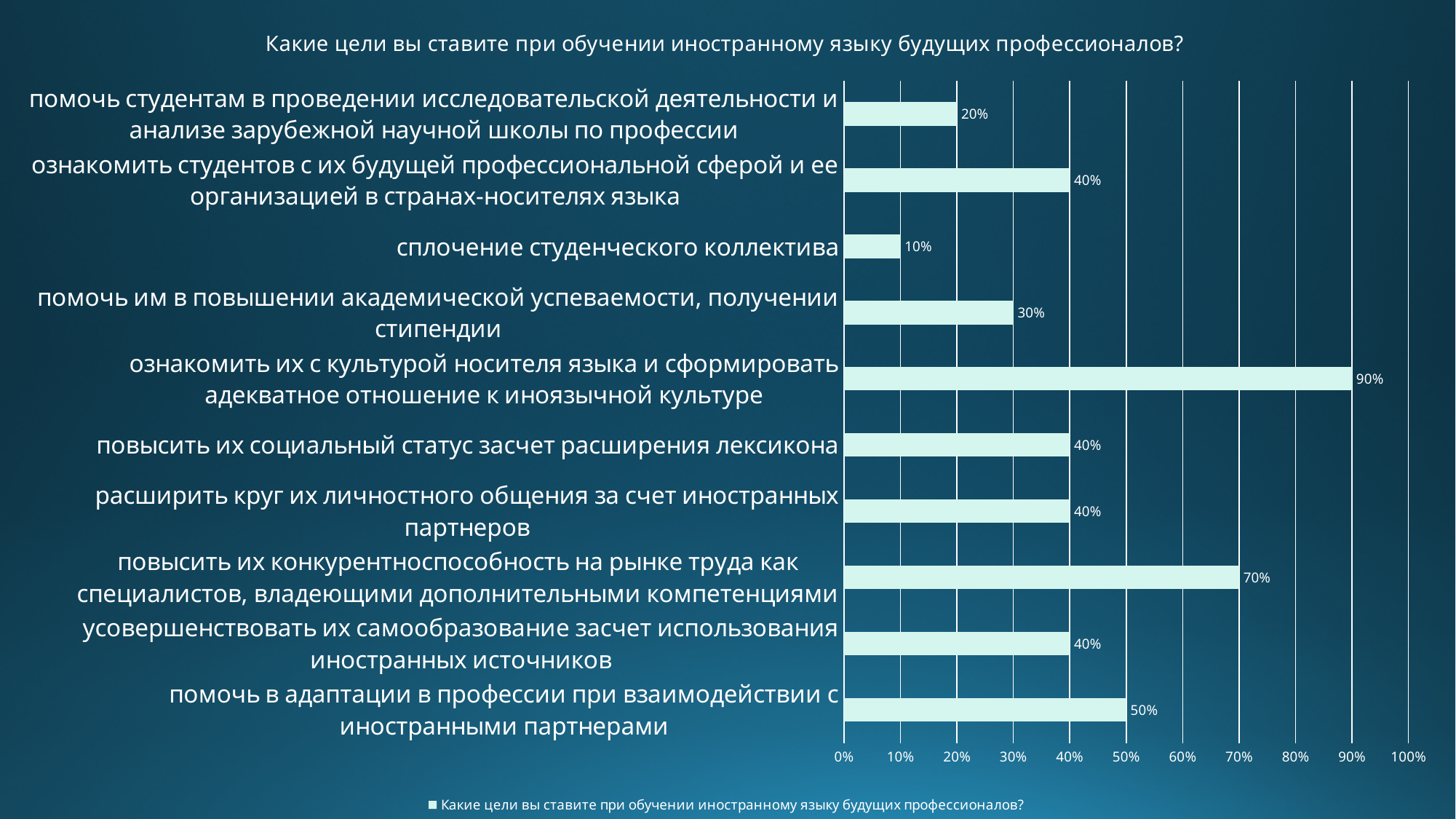
What is the difference between the value for "ознакомить их с культурой носителя языка и сформировать адекватное отношение к иноязычной культуре" and the value for "помочь в адаптации в профессии при взаимодействии с иностранными партнерами"? 40% What is the title of the chart? Какие цели вы ставите при обучении иностранному языку будущих профессионалов? Which category has the highest value? ознакомить их с культурой носителя языка и сформировать адекватное отношение к иноязычной культуре What is the value for "сплочение студенческого коллектива"? 10% How many series does the legend list? 1 What is the value for "повысить их конкурентноспособность на рынке труда как специалистов, владеющими дополнительными компетенциями"? 70% What kind of chart is shown on the slide? bar chart Which is larger: the value for "помочь студентам в проведении исследовательской деятельности и анализе зарубежной научной школы по профессии" or the value for "помочь им в повышении академической успеваемости, получении стипендии"? помочь им в повышении академической успеваемости, получении стипендии What is the value for "помочь в адаптации в профессии при взаимодействии с иностранными партнерами"? 50% Which category has the lowest value? сплочение студенческого коллектива What is the value for "помочь им в повышении академической успеваемости, получении стипендии"? 30% How many categories are shown in the chart? 10